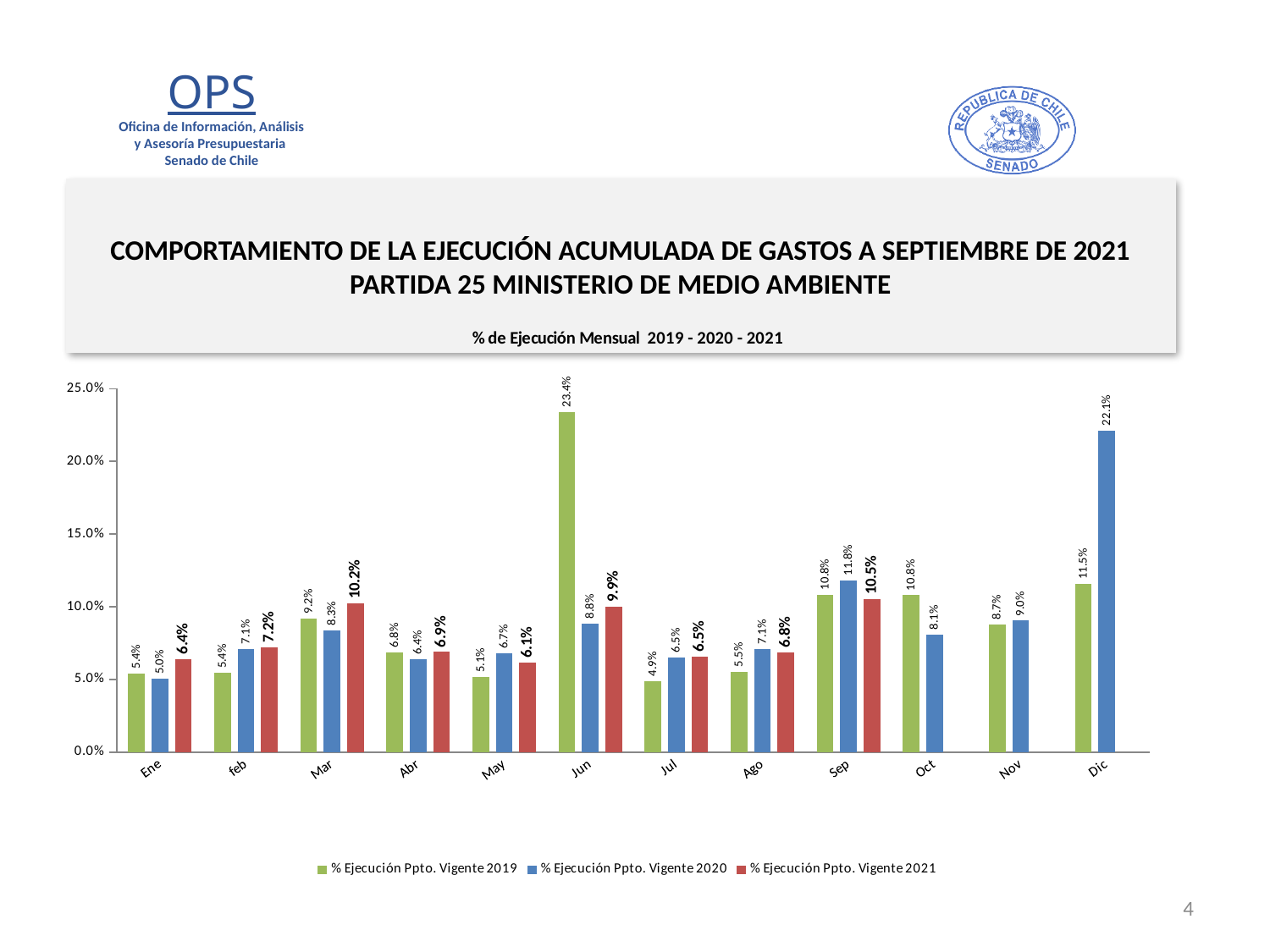
What is the value for % Ejecución Ppto. Vigente 2021 in Mar? 10.2% How many months are shown on the x axis? 12 Is the value for % Ejecución Ppto. Vigente 2019 in Jun greater or less than 20.0%? greater In which month is the % Ejecución Ppto. Vigente 2020 value highest? Dic In which month is the % Ejecución Ppto. Vigente 2019 value lowest? Jul What is the value for % Ejecución Ppto. Vigente 2019 in Jun? 23.4% What kind of chart is shown on the slide? Bar chart How many series does the legend list? 3 What is the value for % Ejecución Ppto. Vigente 2020 in Dic? 22.1% What is the value for % Ejecución Ppto. Vigente 2021 in Sep? 10.5% Which is larger in Sep: the 2020 value or the 2021 value? 2020 value (11.8%) What is the difference between the 2019 and 2020 values in Jun? 14.6%